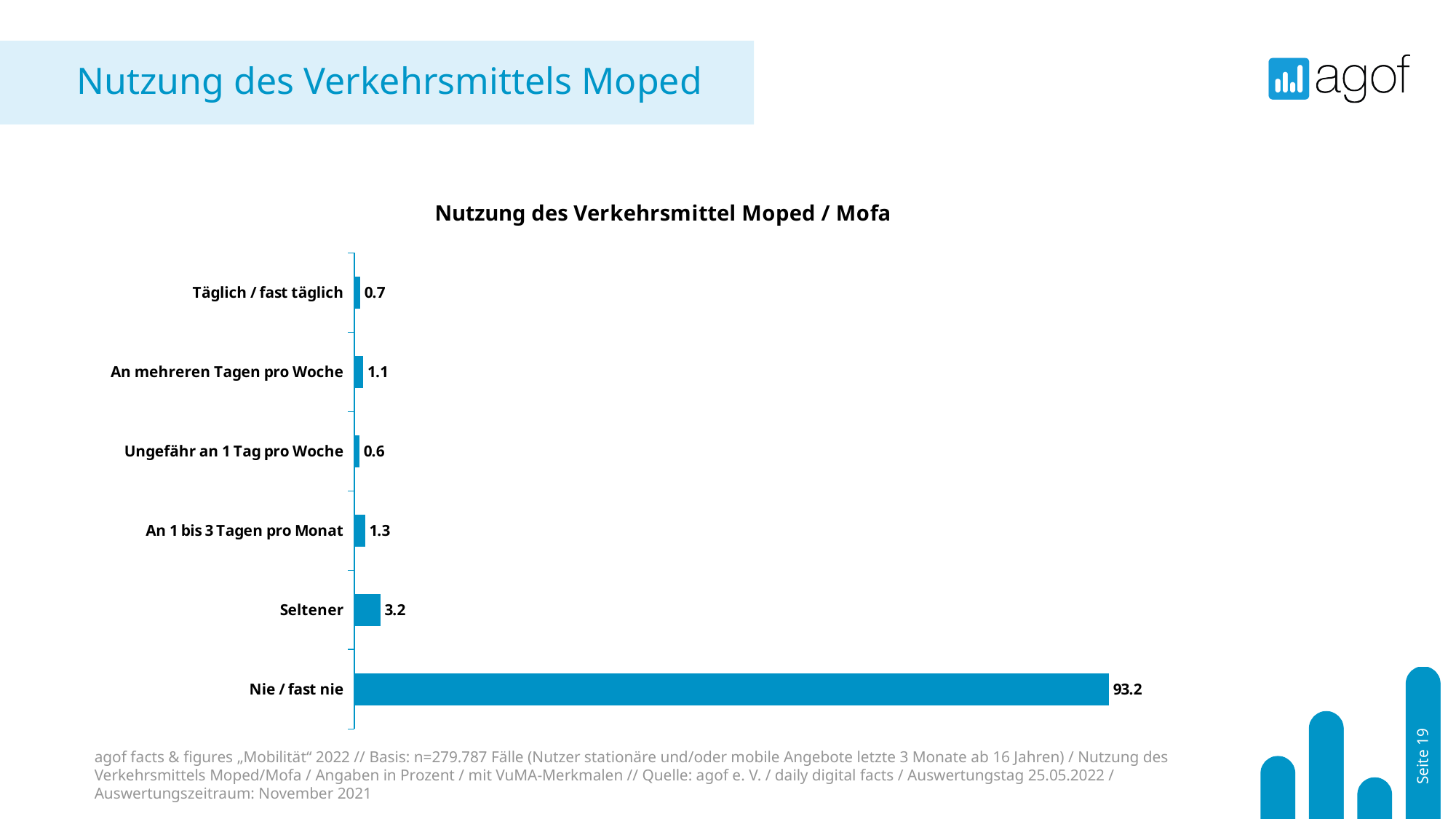
Which category has the highest value? Nie / fast nie Which is larger, the value for "An 1 bis 3 Tagen pro Monat" or the value for "Täglich / fast täglich"? An 1 bis 3 Tagen pro Monat What is the difference between the values for "Nie / fast nie" and "Seltener"? 90.0 How many categories are shown in the chart? 6 What is the value for "An 1 bis 3 Tagen pro Monat"? 1.3 What is the value for "Täglich / fast täglich"? 0.7 Which category has the lowest value? Ungefähr an 1 Tag pro Woche What kind of chart is shown on the slide? Bar chart What is the difference between the values for "An mehreren Tagen pro Woche" and "Ungefähr an 1 Tag pro Woche"? 0.5 What is the title of the chart? Nutzung des Verkehrsmittel Moped / Mofa What is the value for "Nie / fast nie"? 93.2 What is the value for "Seltener"? 3.2